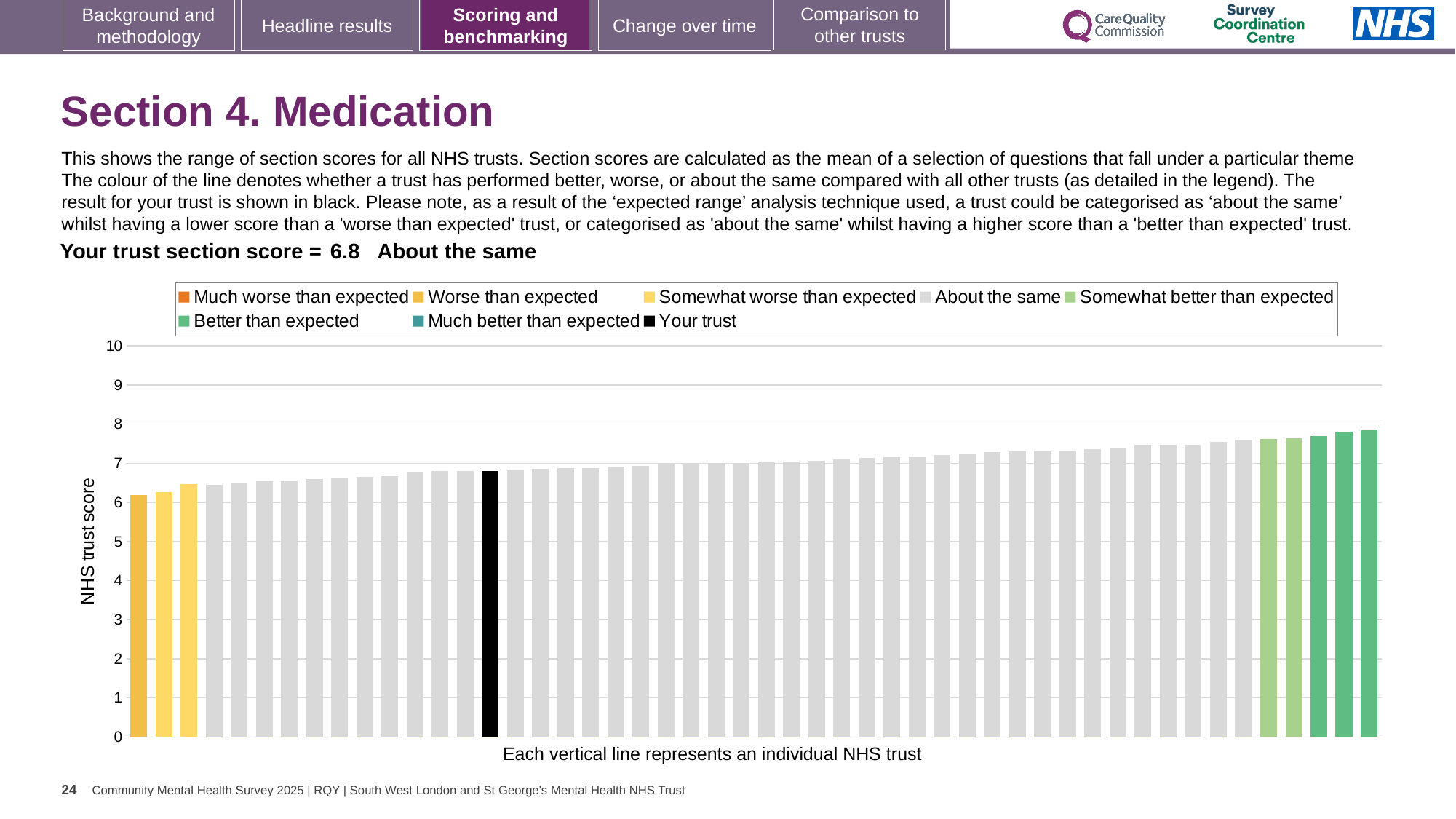
How many bars are coloured as 'Somewhat better than expected'? 2 Is the value of the lowest bar greater or less than 6? greater Which legend category does the highest bar belong to? Better than expected Do the bar values rise or fall from left to right along the x axis? rise Is the value for your trust (the black bar) greater or less than 7? less Is the value of the highest bar greater or less than 8? less Which legend category does the lowest bar belong to? Worse than expected What is the section score for your trust shown on the slide? 6.8 What kind of chart is shown on the slide? bar chart Which category is your trust's section score placed in? About the same How many bars are coloured as 'Worse than expected'? 1 How many entries does the chart legend list? 8